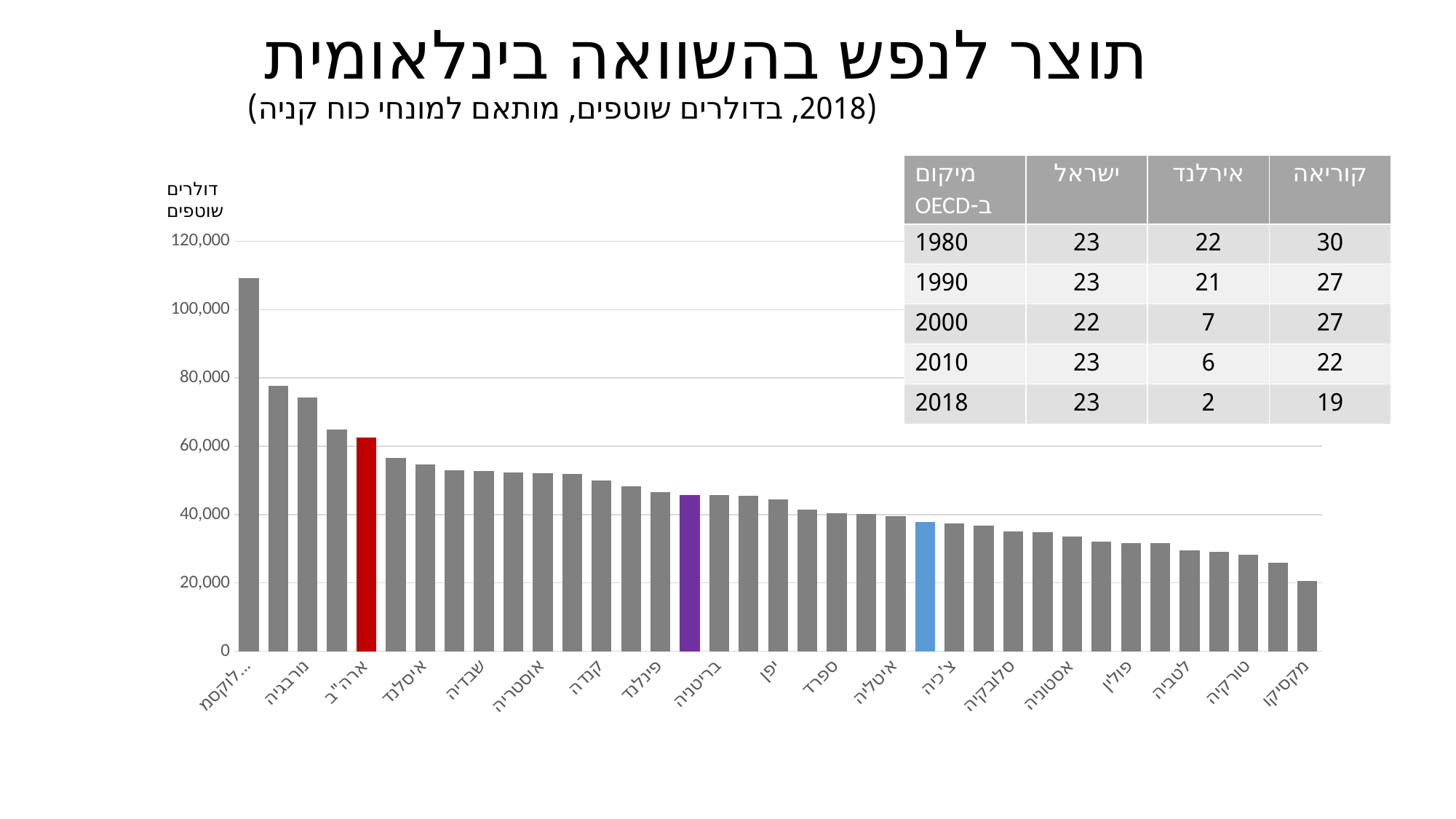
Is the value for מקסיקו greater or less than 40,000? less Which country has the lowest value in the bar chart? מקסיקו Which country has the highest value in the bar chart? לוקסמבורג Is the value for נורבגיה greater or less than 60,000? greater Is the value for יפן greater or less than 40,000? greater What colour is the bar for ארה"ב? red What kind of chart is shown on the slide? bar chart Which has the larger value, קנדה or יפן? קנדה Which has the larger value, ספרד or טורקיה? ספרד Do the bar values rise or fall from left to right along the x axis? fall